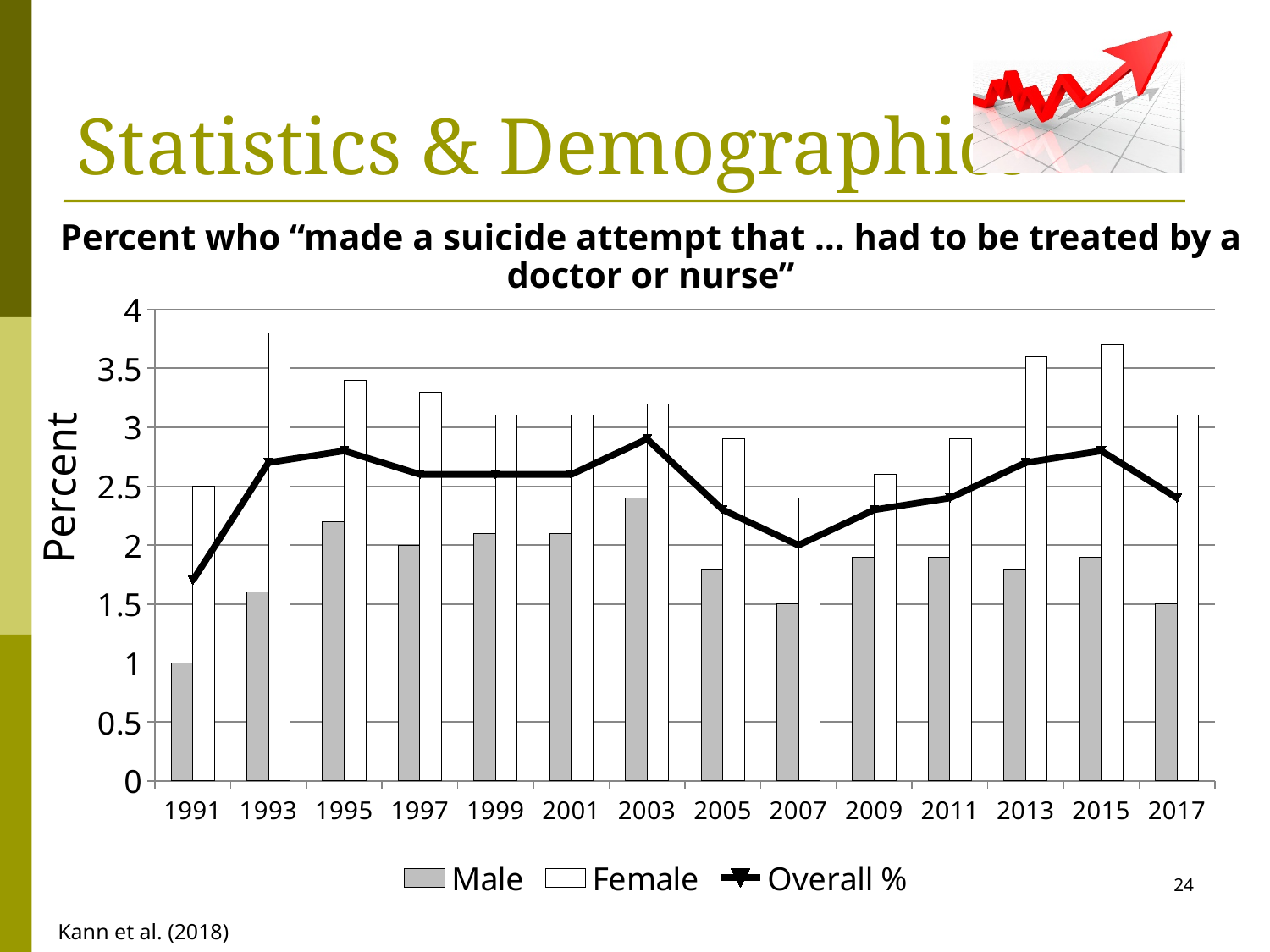
What are the three entries in the legend? Male, Female, Overall % Does the Overall % line rise or fall from 2015 to 2017? fall How many series does the legend list? 3 Which is larger, the Female value for 2005 or the Female value for 2007? 2005 Which year has the lowest Male value? 1991 Which is larger, the Male value for 2003 or the Male value for 2007? 2003 Is the Female value for 1993 greater or less than 3.5? greater Is the Overall % value for 1991 greater or less than 2? less What is the Male value for 1991? 1 What kind of chart is shown on the slide? bar chart with a line Is the Male value for 2003 greater or less than 2? greater How many years are shown on the x axis? 14